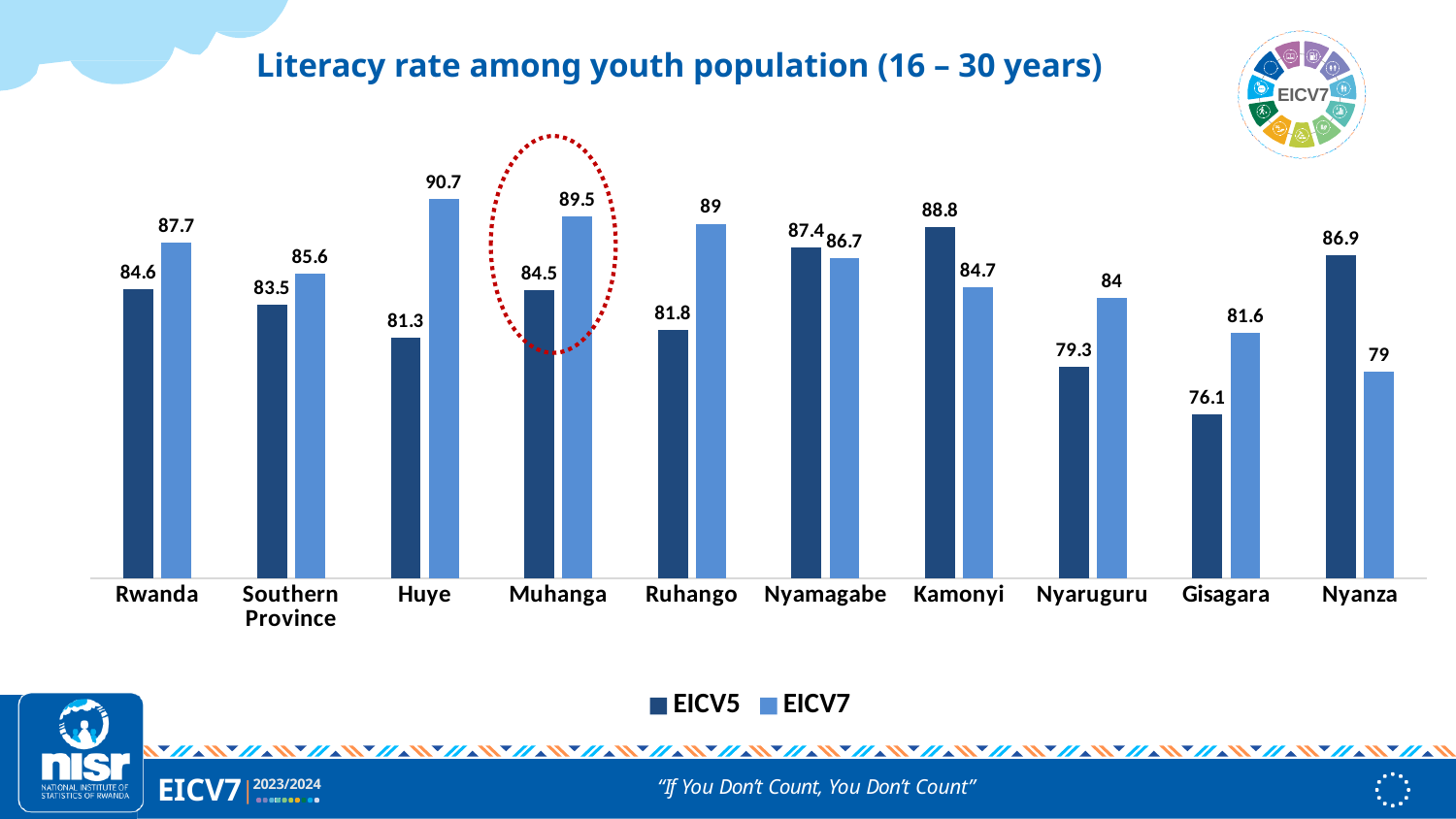
What is the difference between the EICV7 and EICV5 values for Huye? 9.4 What is the EICV7 literacy rate for Huye? 90.7 What kind of chart is shown on the slide? Bar chart What is the EICV7 value for Muhanga? 89.5 What is the difference between the EICV5 and EICV7 values for Nyanza? 7.9 Which category has the highest EICV5 value? Kamonyi Which category has the lowest EICV5 value? Gisagara Which is larger for Kamonyi, the EICV5 value or the EICV7 value? EICV5 How many categories are shown on the x axis? 10 How many series does the legend list? 2 What is the EICV5 literacy rate for Gisagara? 76.1 Which category has the highest EICV7 value? Huye